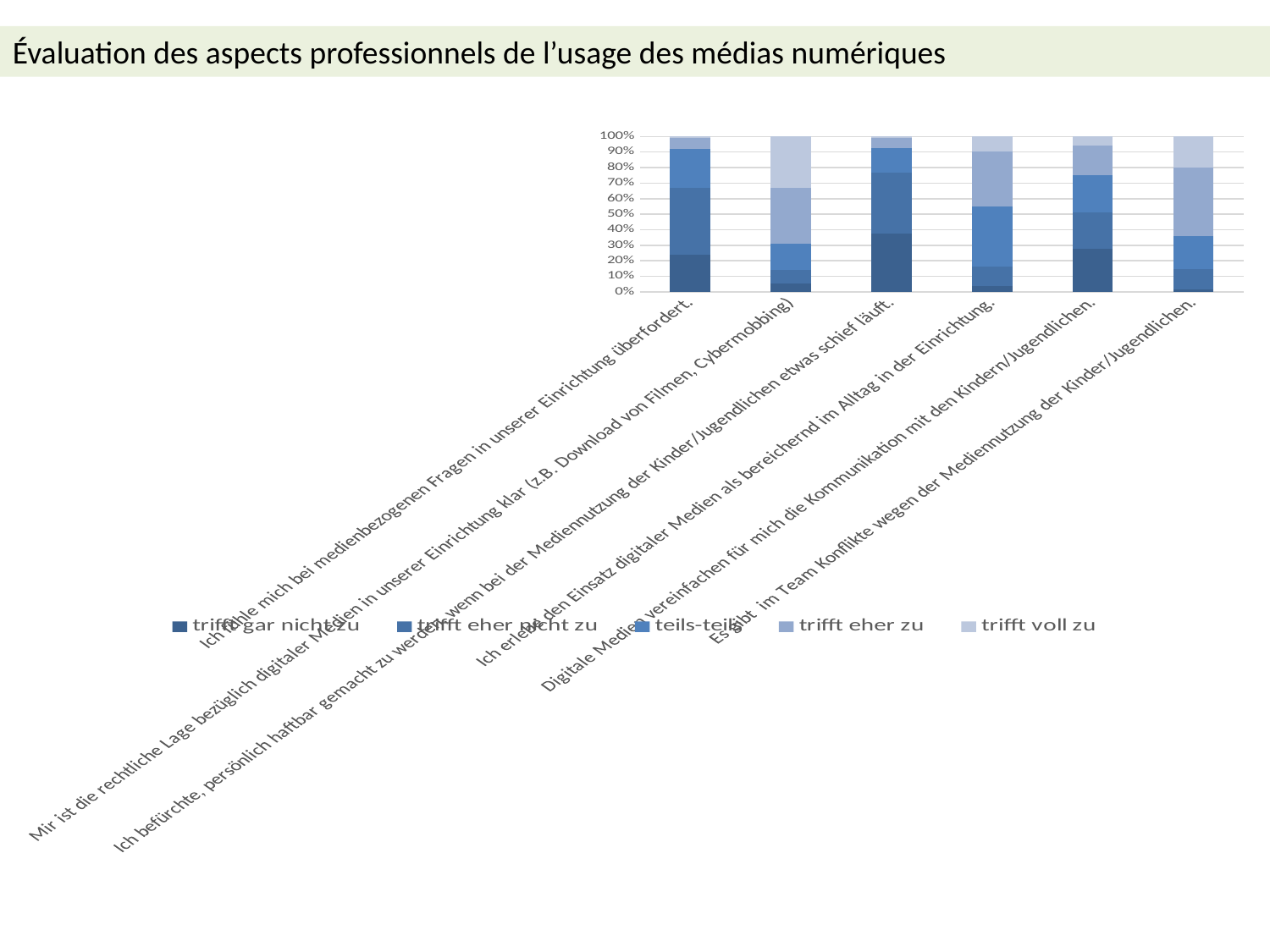
What is the highest value shown on the vertical axis of the chart? 100% Which has the larger 'trifft gar nicht zu' share: 'Ich fühle mich bei medienbezogenen Fragen in unserer Einrichtung überfordert.' or 'Ich befürchte, persönlich haftbar gemacht zu werden, wenn bei der Mediennutzung der Kinder/Jugendlichen etwas schief läuft.'? Ich befürchte, persönlich haftbar gemacht zu werden, wenn bei der Mediennutzung der Kinder/Jugendlichen etwas schief läuft. Is the 'trifft gar nicht zu' share for 'Ich fühle mich bei medienbezogenen Fragen in unserer Einrichtung überfordert.' greater or less than 30%? less Is the 'trifft voll zu' share for 'Mir ist die rechtliche Lage bezüglich digitaler Medien in unserer Einrichtung klar (z.B. Download von Filmen, Cybermobbing)' greater or less than 20%? greater How many categories (statements) are plotted along the x axis of the chart? 6 Is the 'trifft gar nicht zu' share for 'Ich befürchte, persönlich haftbar gemacht zu werden, wenn bei der Mediennutzung der Kinder/Jugendlichen etwas schief läuft.' greater or less than 30%? greater What is the first entry in the chart legend? trifft gar nicht zu How many series does the chart legend list? 5 What kind of chart is shown on the slide? Stacked bar chart Which statement has the largest 'trifft gar nicht zu' segment? Ich befürchte, persönlich haftbar gemacht zu werden, wenn bei der Mediennutzung der Kinder/Jugendlichen etwas schief läuft. Which statement has the largest 'trifft voll zu' segment? Mir ist die rechtliche Lage bezüglich digitaler Medien in unserer Einrichtung klar (z.B. Download von Filmen, Cybermobbing)